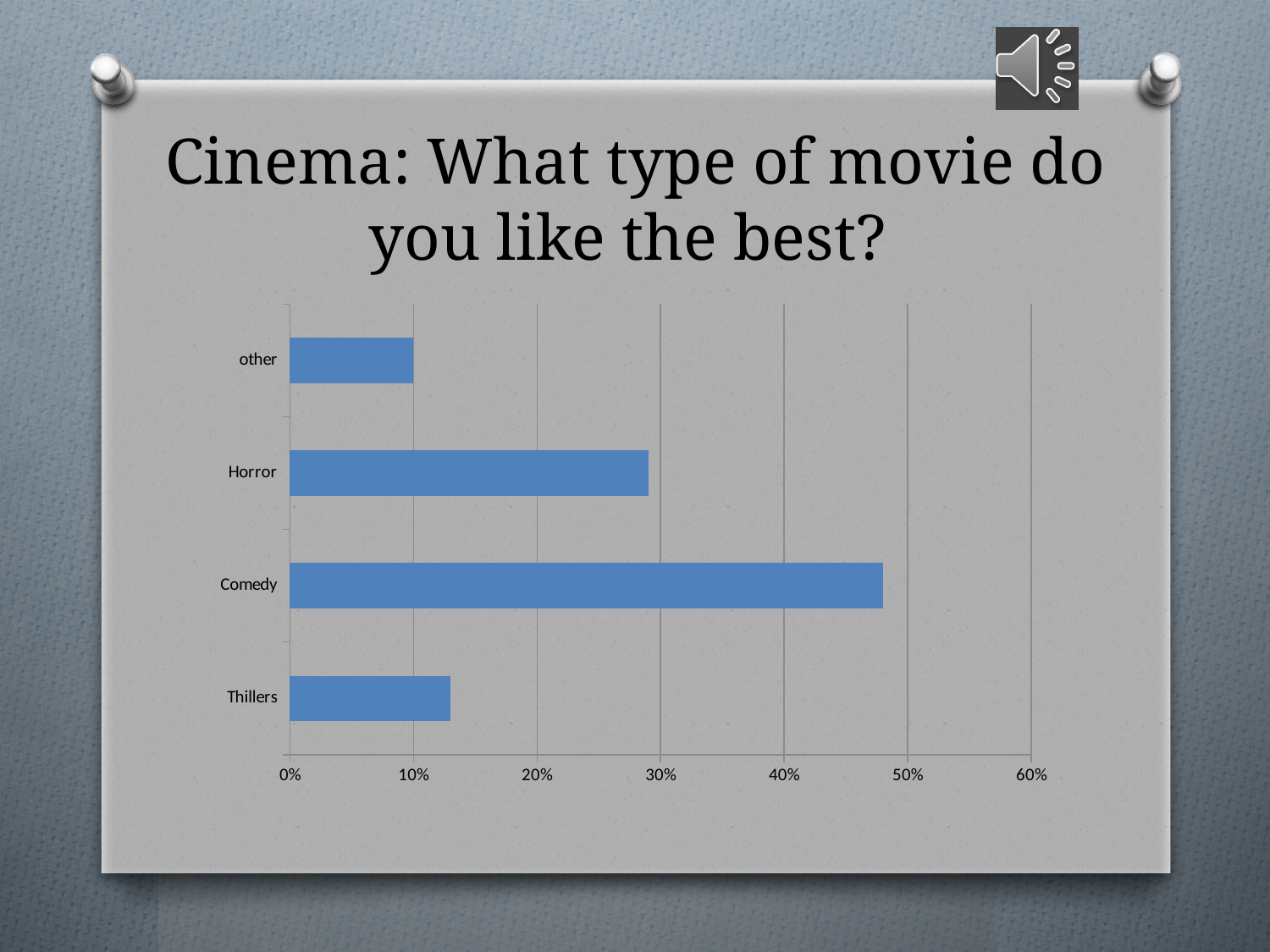
Which movie type has the highest value in the chart? Comedy What is the value for "other" in the chart? 10% Is the value for Comedy greater or less than 50%? less What is the title of the slide containing the chart? Cinema: What type of movie do you like the best? Which movie type has the lowest value in the chart? other Is the value for Comedy greater or less than 40%? greater Which has a larger value, Horror or Thillers? Horror Is the value for Thillers greater or less than 20%? less What kind of chart is shown on the slide? bar chart How many movie types (categories) are shown in the chart? 4